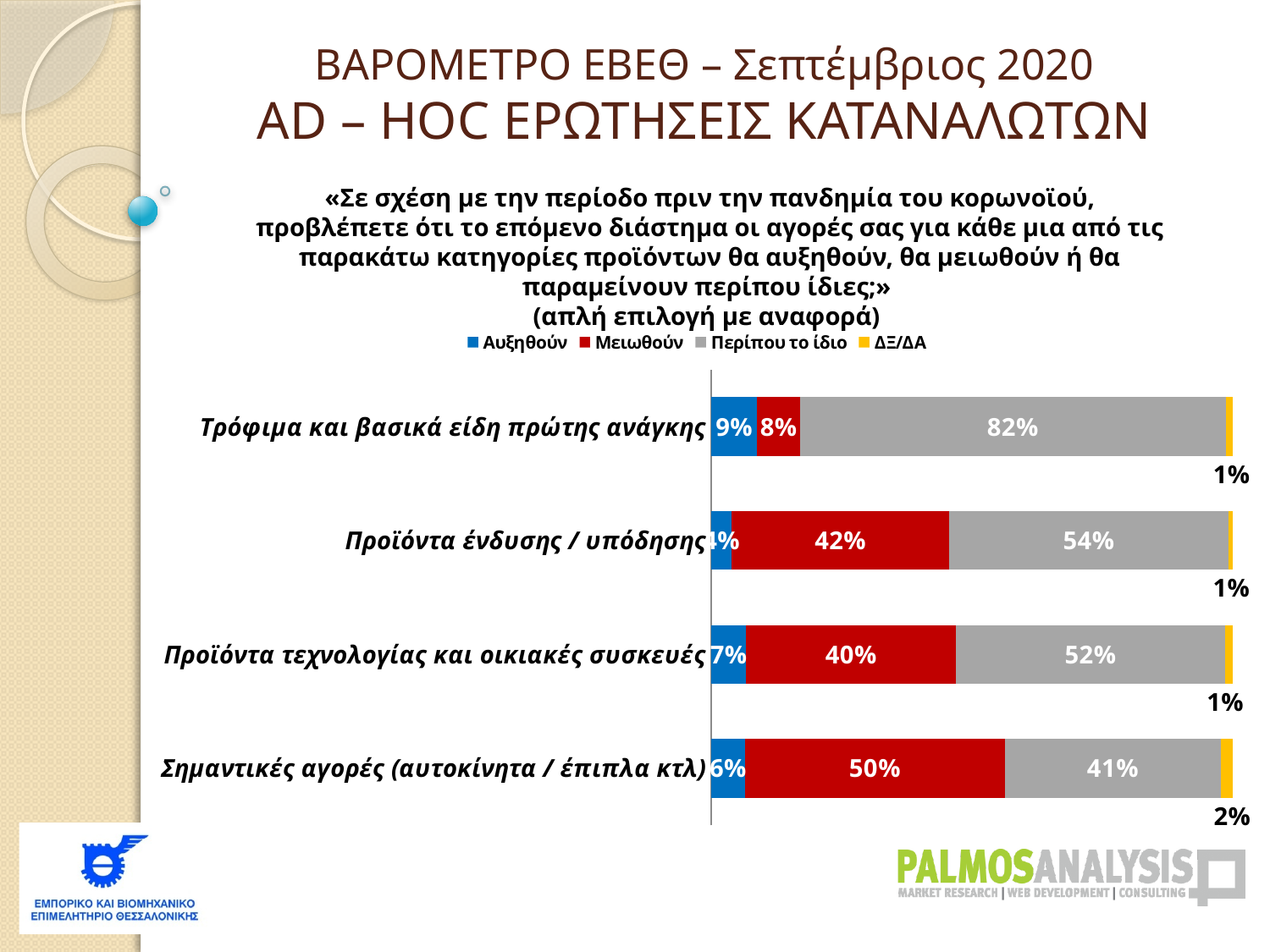
Which category has the highest 'Μειωθούν' value? Σημαντικές αγορές (αυτοκίνητα / έπιπλα κτλ) How many series does the legend list? 4 What is the value of 'ΔΞ/ΔΑ' for 'Σημαντικές αγορές (αυτοκίνητα / έπιπλα κτλ)'? 2% What is the difference between the 'Μειωθούν' values for 'Σημαντικές αγορές (αυτοκίνητα / έπιπλα κτλ)' and 'Προϊόντα τεχνολογίας και οικιακές συσκευές'? 10% What kind of chart is shown on the slide? Stacked bar chart What is the value of 'Περίπου το ίδιο' for 'Τρόφιμα και βασικά είδη πρώτης ανάγκης'? 82% Which category has the lowest 'Περίπου το ίδιο' value? Σημαντικές αγορές (αυτοκίνητα / έπιπλα κτλ) What is the value of 'Μειωθούν' for 'Προϊόντα ένδυσης / υπόδησης'? 42% Which is larger: the 'Περίπου το ίδιο' value for 'Προϊόντα ένδυσης / υπόδησης' or for 'Προϊόντα τεχνολογίας και οικιακές συσκευές'? Προϊόντα ένδυσης / υπόδησης How many product categories are shown in the chart? 4 What is the value of 'Αυξηθούν' for 'Προϊόντα τεχνολογίας και οικιακές συσκευές'? 7% Which colour represents the 'Μειωθούν' series in the chart? Red